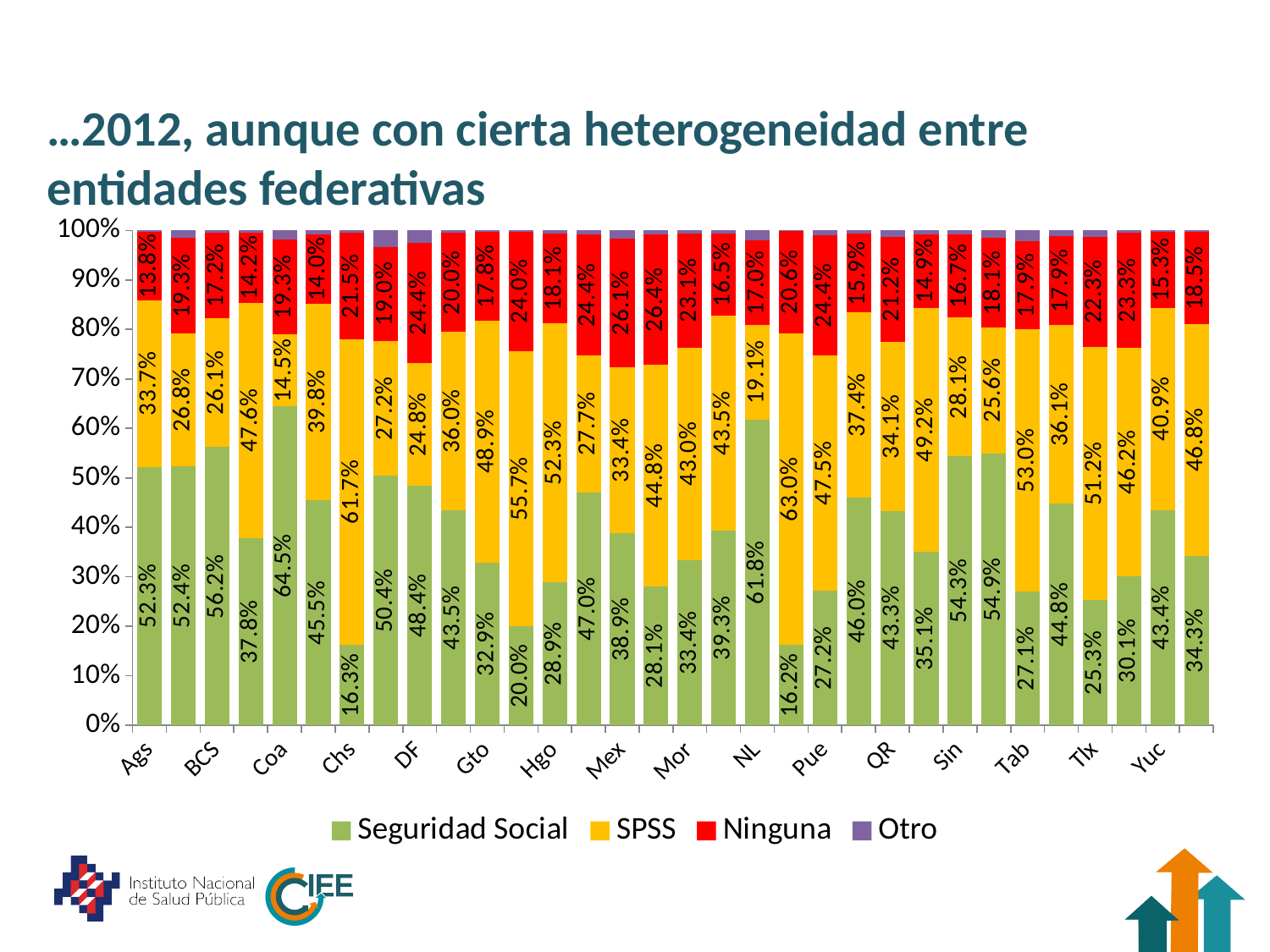
Among the labelled states, which has the highest Seguridad Social value? Coa Which has the larger Seguridad Social value, Ags or Chs? Ags What is the Seguridad Social value for Coa? 64.5% What is the SPSS value for Chs? 61.7% Is the Seguridad Social value for Hgo greater or less than 30%? less What is the Ninguna value for DF? 24.4% What is the difference between the SPSS value and the Seguridad Social value for Tab? 25.9% What is the Seguridad Social value for NL? 61.8% What is the SPSS value for Yuc? 40.9% Which colour represents the Ninguna series in the legend? red How many series does the legend list? 4 What kind of chart is shown on the slide? stacked bar chart